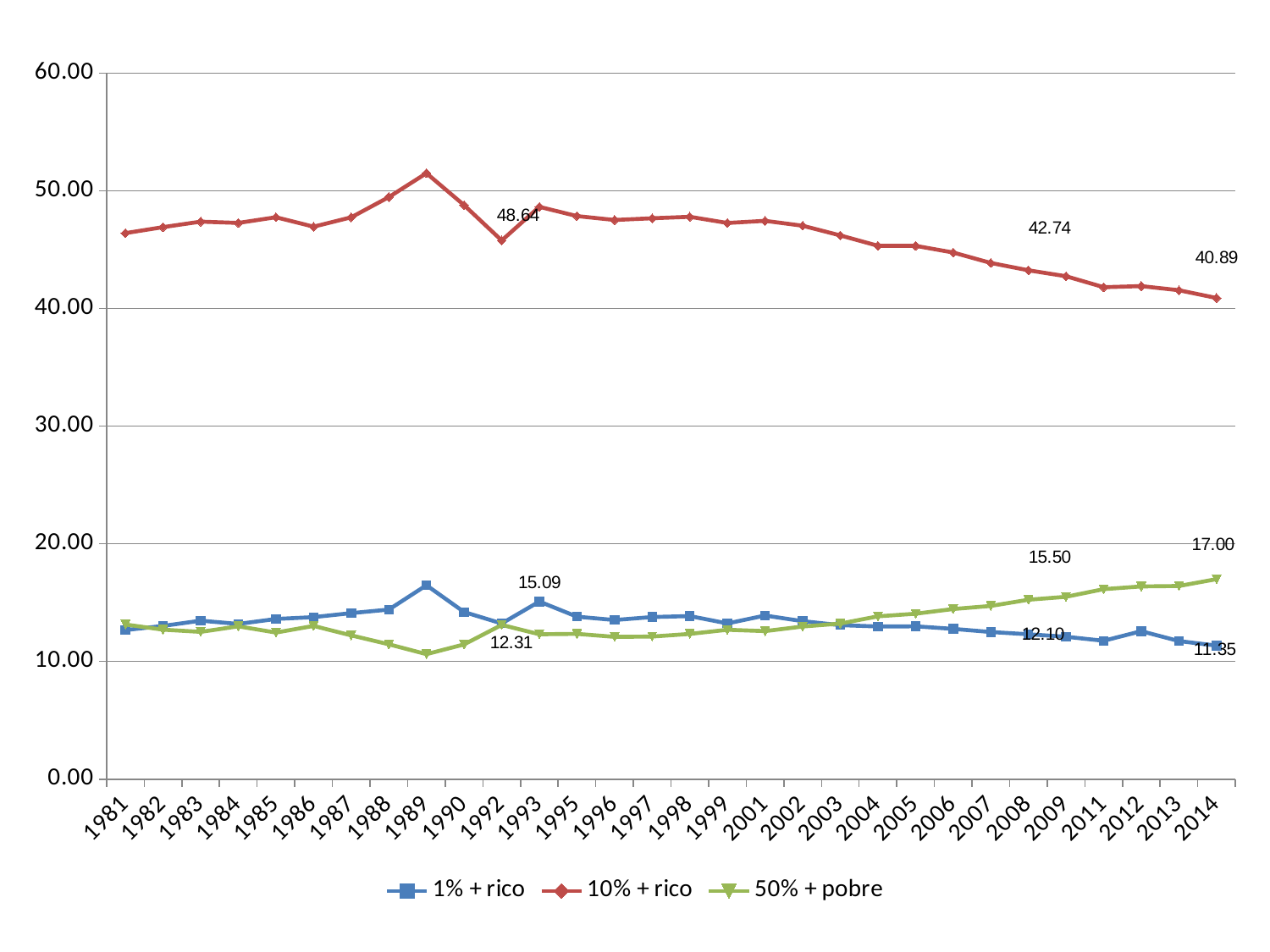
In 2014, what is the difference between the 50% + pobre value and the 1% + rico value? 5.65 By how much did the 10% + rico series fall from 1993 to 2014? 7.75 Does the 10% + rico series rise or fall from 1993 to 2014? fall What is the labelled value of the 1% + rico series in 1993? 15.09 What is the value of the 10% + rico series in 2014? 40.89 What is the value of the 50% + pobre series in 2014? 17.00 Is the value of the 10% + rico series in 1989 greater or less than 50.00? greater What is the value of the 1% + rico series in 2014? 11.35 How many series does the legend list? 3 In 2014, which is larger: the 50% + pobre value or the 1% + rico value? 50% + pobre What kind of chart is shown on the slide? line chart What is the labelled value of the 10% + rico series in 1993? 48.64